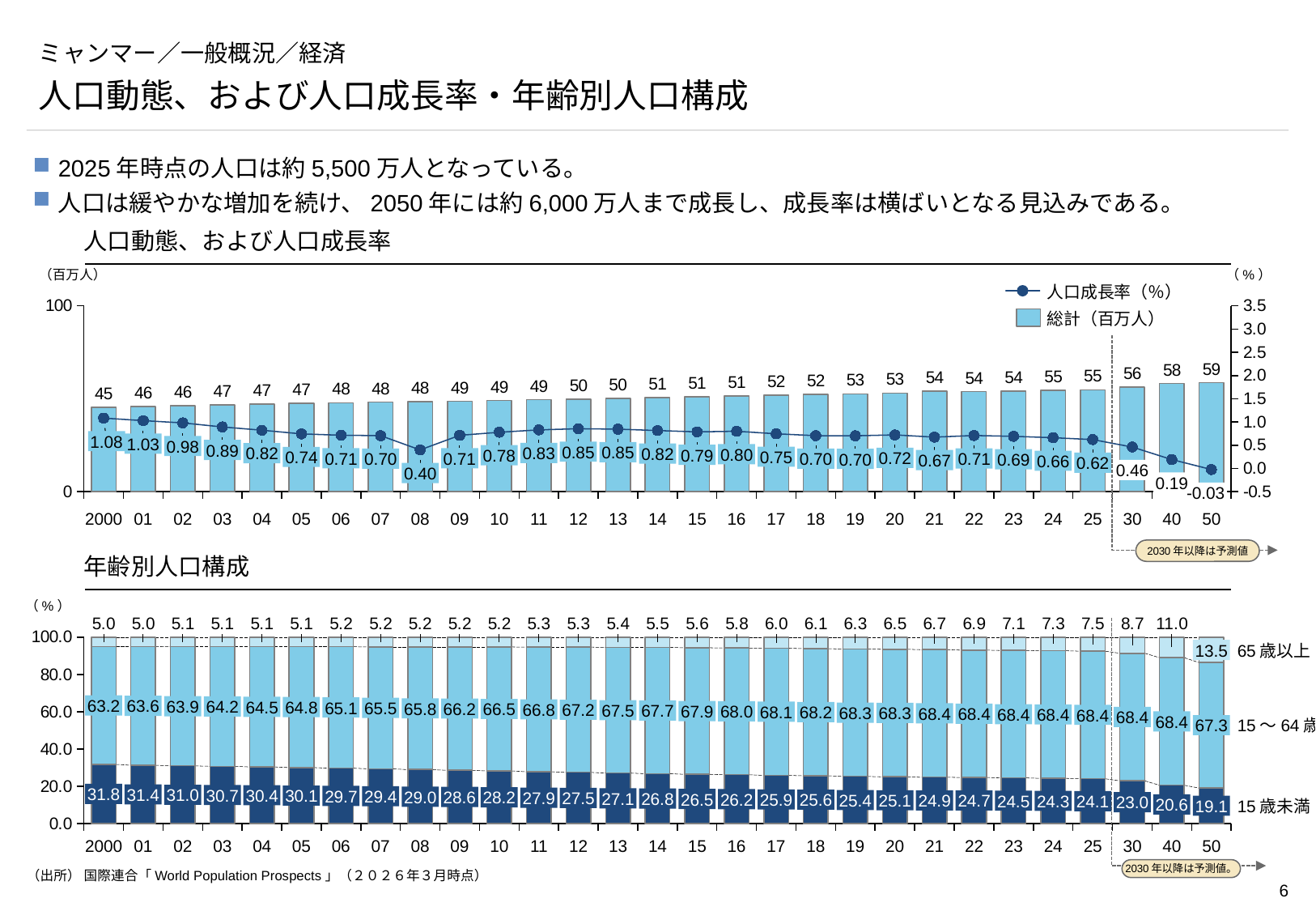
In the top chart (人口動態、および人口成長率), which year has the highest population growth rate? 2000 In the bottom chart (年齢別人口構成), which is larger: the 15歳未満 value in 2000 or in 50 (2050)? 2000 In the bottom chart (年齢別人口構成), what is the value for 15歳未満 in 2000? 31.8 In the bottom chart (年齢別人口構成), what is the share of 65歳以上 shown for 50 (2050)? 13.5 In the top chart (人口動態、および人口成長率), what is the difference between the total population in 50 (2050) and in 2000? 14 In the top chart (人口動態、および人口成長率), what is the total population (総計) shown for 2000? 45 In the top chart (人口動態、および人口成長率), what is the population growth rate shown for 50 (2050)? -0.03 In the top chart (人口動態、および人口成長率), what is the population growth rate (人口成長率) shown for 2008? 0.40 In the top chart (人口動態、および人口成長率), does the total population rise or fall from 2000 to 2050? rise What kind of chart is the bottom chart (年齢別人口構成)? stacked bar chart In the top chart (人口動態、および人口成長率), how many series does the legend list? 2 In the bottom chart (年齢別人口構成), what is the total of the stacked bar for 2000? 100.0